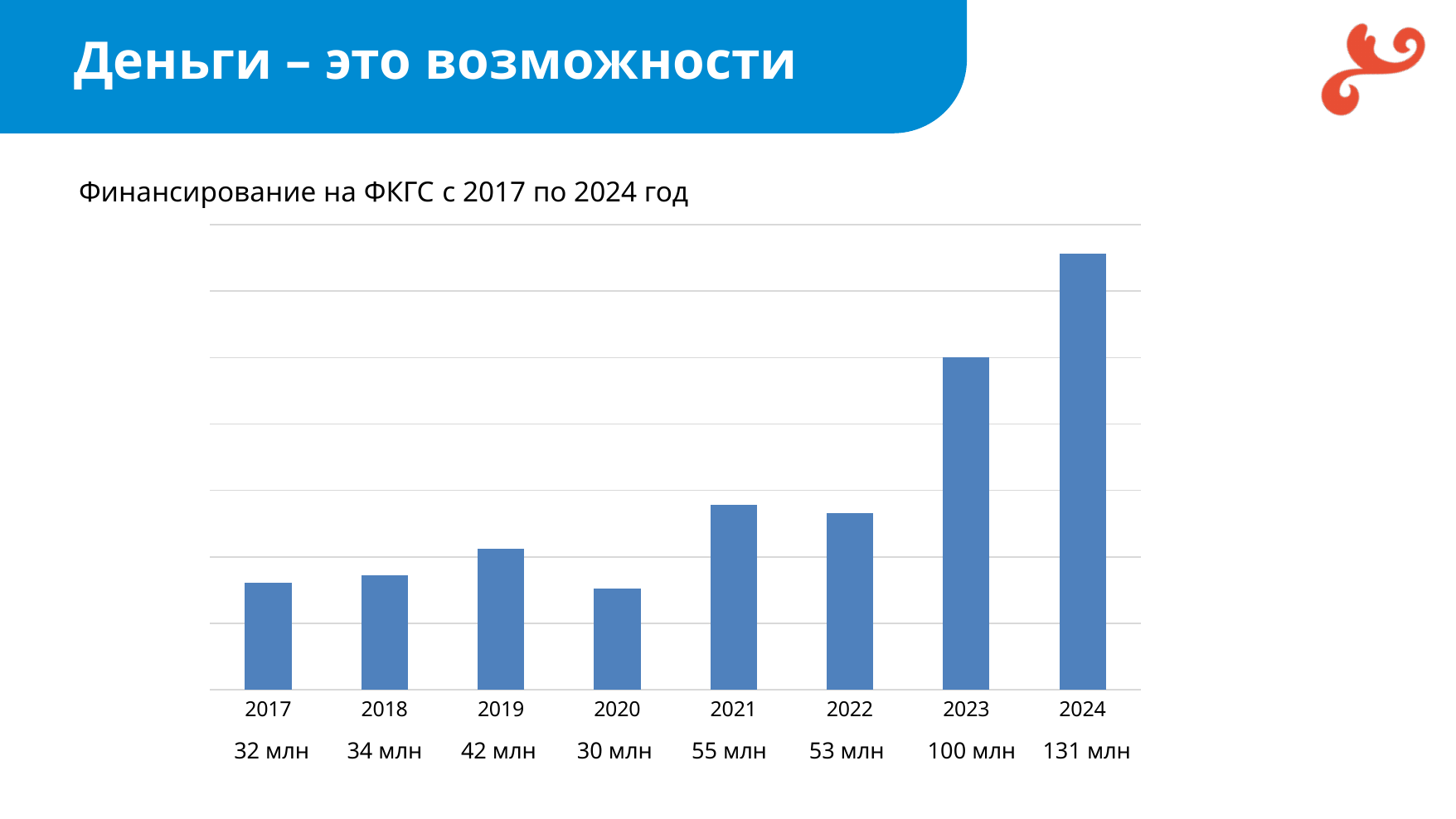
How many years are shown on the chart? 8 What is the funding value for 2021? 55 млн What is the funding value for 2019? 42 млн Which year has higher funding, 2018 or 2019? 2019 Which year has the lowest funding? 2020 What kind of chart is shown on the slide? Bar chart What is the title of the chart? Финансирование на ФКГС с 2017 по 2024 год What is the difference between the funding in 2024 and in 2023? 31 млн What is the difference between the funding in 2021 and in 2020? 25 млн Which year has higher funding, 2021 or 2022? 2021 Which year has the highest funding? 2024 What is the funding value for 2023? 100 млн